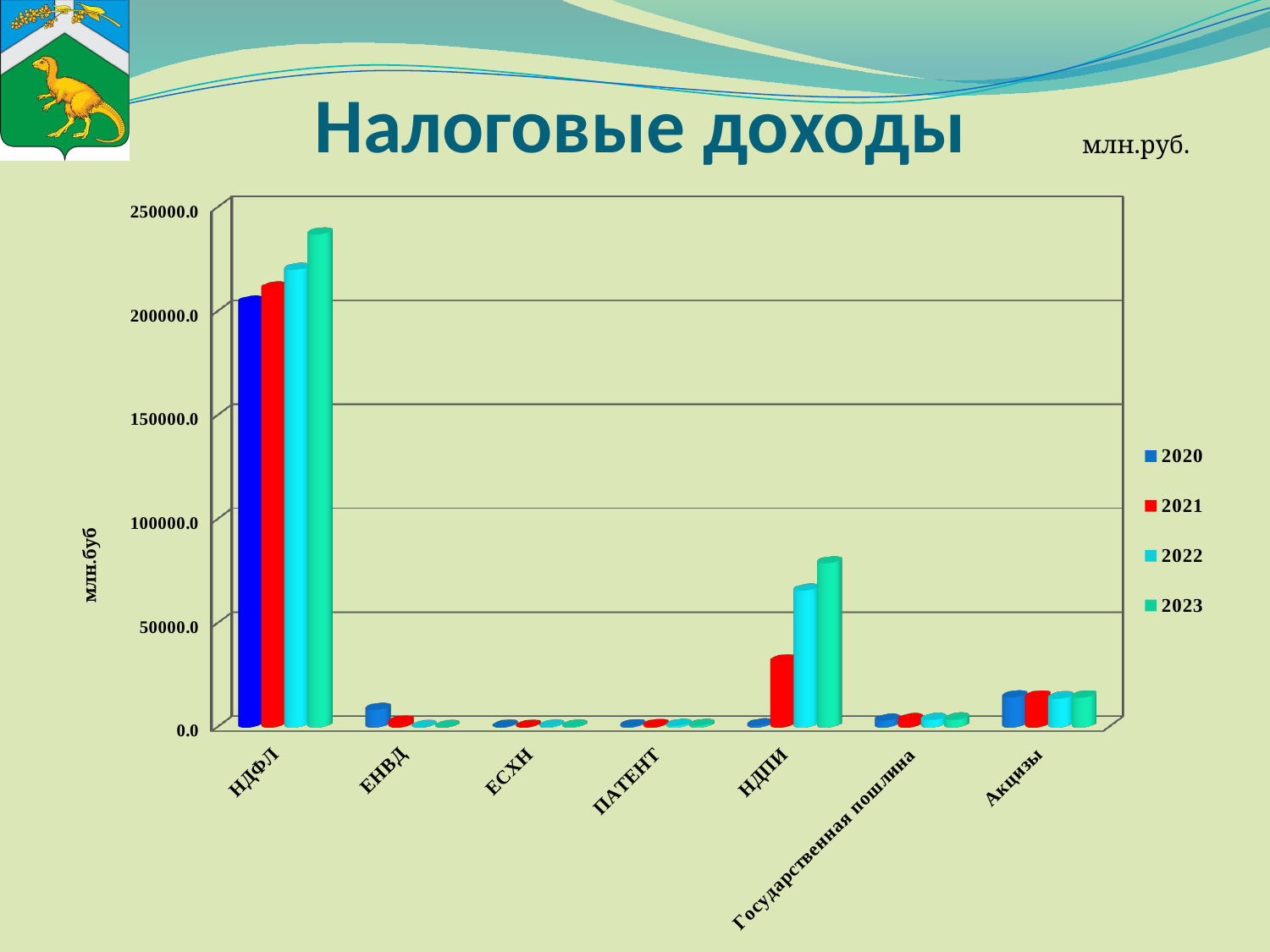
Which is larger in 2023: НДПИ or Акцизы? НДПИ Is the 2022 value for НДПИ greater or less than 50000.0? greater Is the 2023 value for НДФЛ greater or less than 200000.0? greater Is the 2021 value for НДПИ greater or less than 50000.0? less How many categories are shown on the x axis of the chart? 7 Do the values for НДФЛ rise or fall from 2020 to 2023? rise What kind of chart is shown on the slide? bar chart Which category has the highest values in the chart? НДФЛ What is the title of the chart? Налоговые доходы Which is larger for НДФЛ: the 2020 value or the 2023 value? 2023 How many series does the legend list? 4